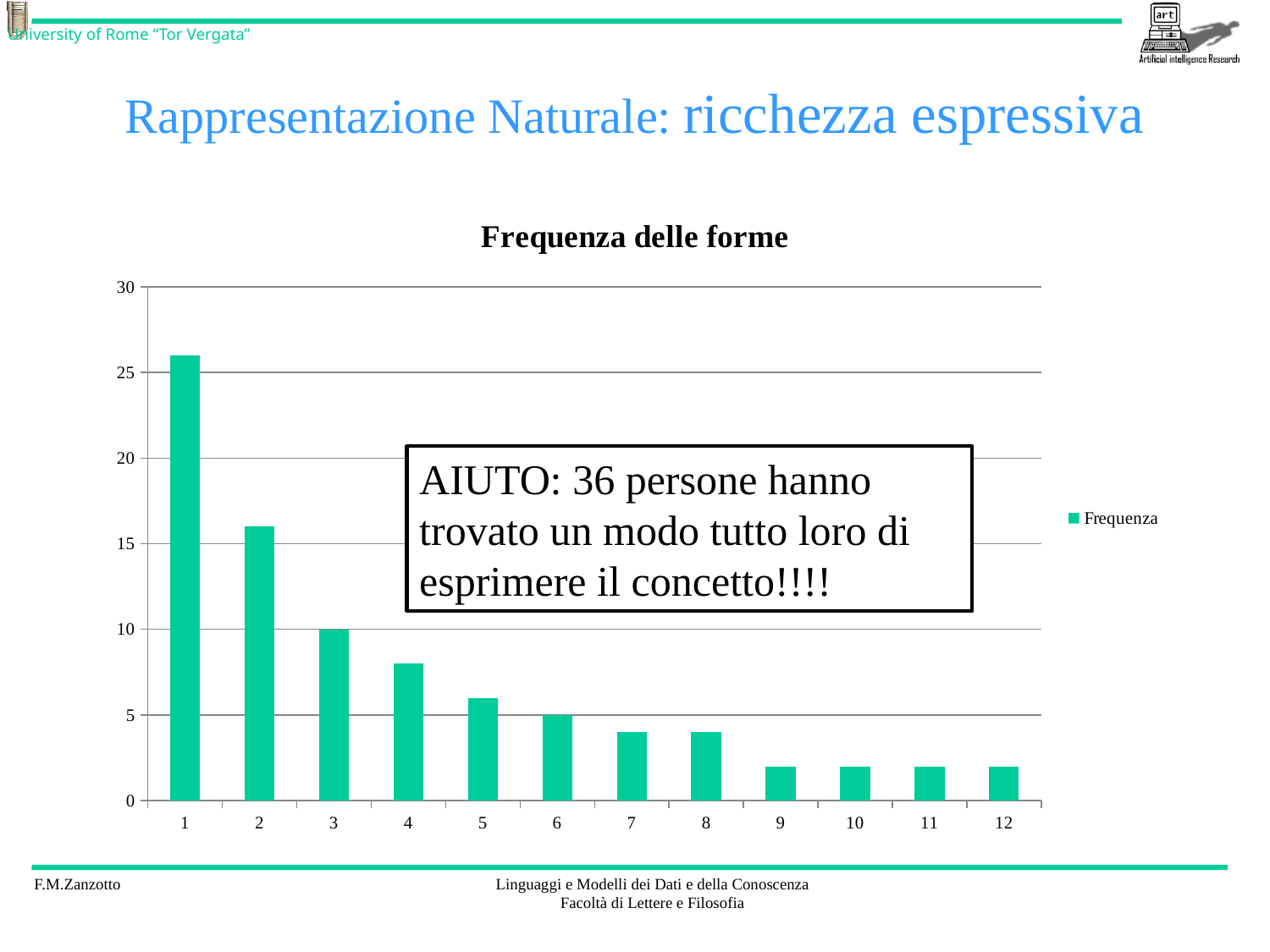
Which category has the highest value? 1 How many series does the legend list? 1 What is the value for category 3? 10 What is the value for category 6? 5 What kind of chart is shown on the slide? bar chart What is the name of the series shown in the legend? Frequenza Is the value for category 2 greater or less than 15? greater Is the value for category 4 greater or less than 10? less How many categories are shown on the x axis of the chart? 12 Is the value for category 1 greater or less than 25? greater Do the values rise or fall as you move from category 1 to category 12 along the x axis? fall What is the title of the chart? Frequenza delle forme